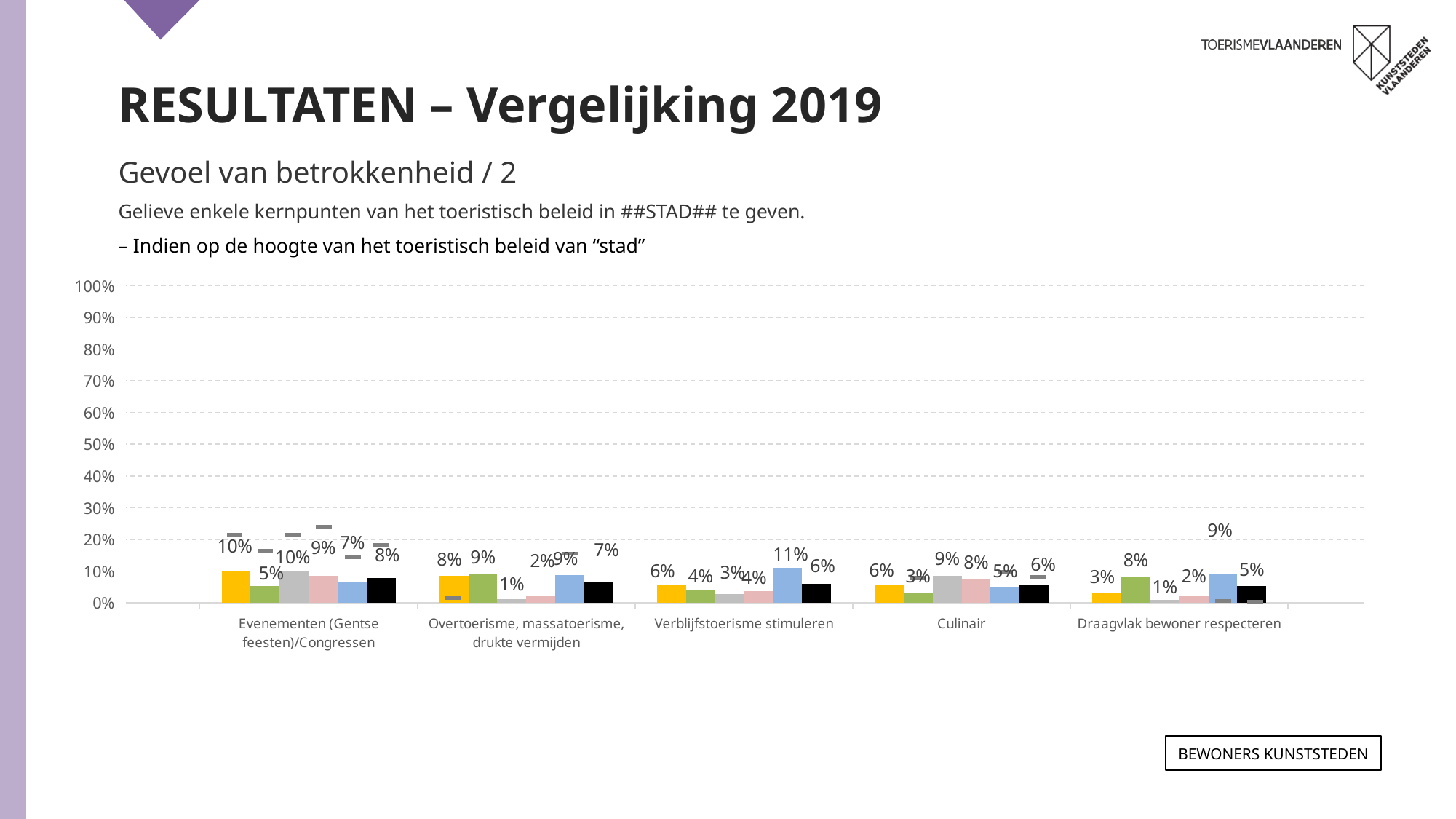
What is the value of the blue bar for 'Verblijfstoerisme stimuleren'? 11% What is the difference between the blue bar (11%) and the grey bar (3%) for 'Verblijfstoerisme stimuleren'? 8% How many coloured bars are plotted for each category in the chart? 6 What kind of chart is shown on the slide? bar chart Which coloured bar is the highest for 'Culinair'? grey (9%) For 'Overtoerisme, massatoerisme, drukte vermijden', which is larger: the green bar or the pink bar? green bar What is the value of the grey bar for 'Overtoerisme, massatoerisme, drukte vermijden'? 1% Is the value of the blue bar for 'Verblijfstoerisme stimuleren' greater or less than 20%? less Which coloured bar is the lowest for 'Draagvlak bewoner respecteren'? grey (1%) What is the value of the green bar for 'Draagvlak bewoner respecteren'? 8% How many categories are shown on the x axis of the chart? 5 What is the value of the yellow bar for 'Evenementen (Gentse feesten)/Congressen'? 10%